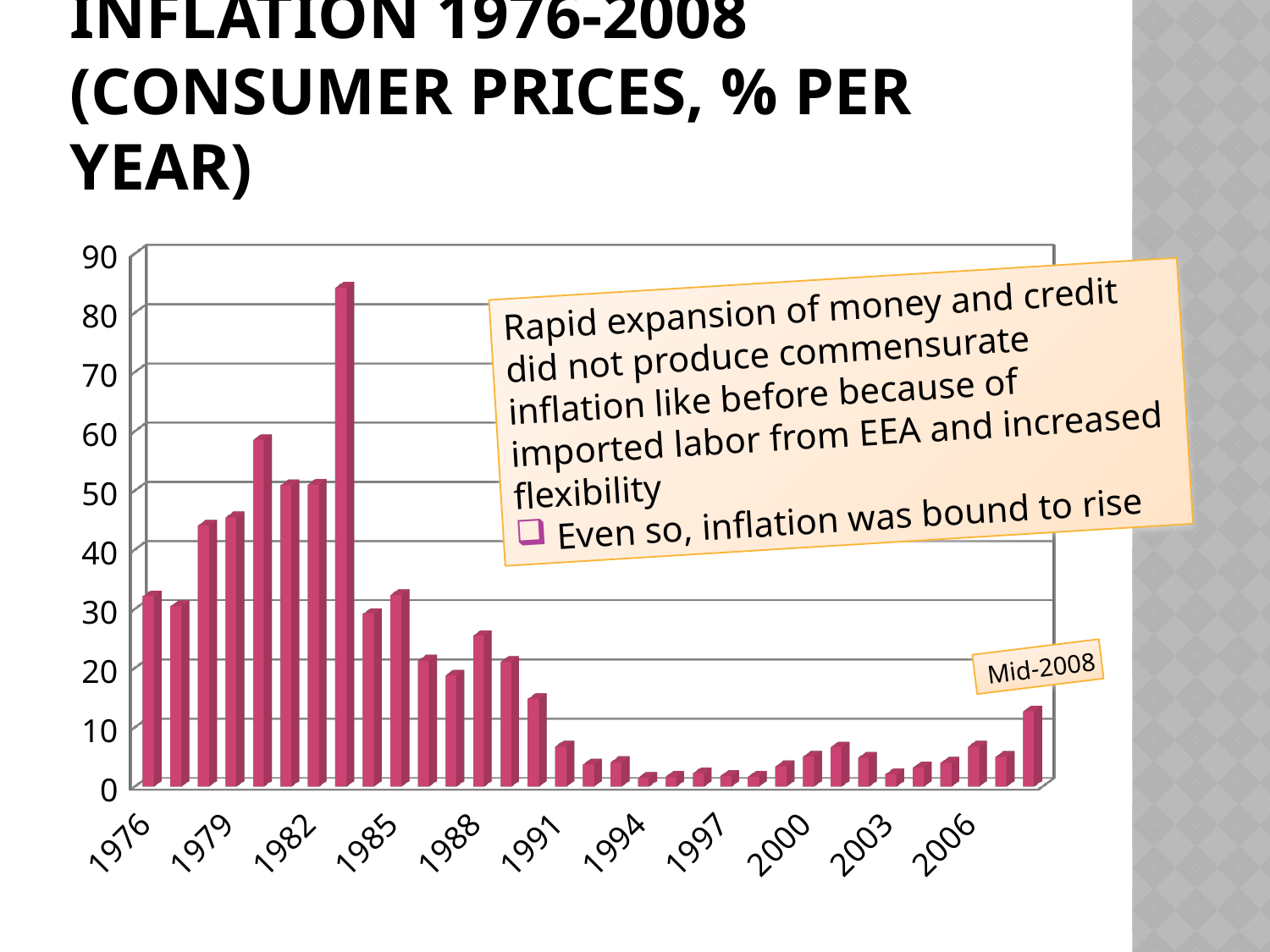
What kind of chart is shown on the slide? bar chart Is the value for the bar labelled Mid-2008 greater or less than 10? greater Is the value for 1979 greater or less than 40? greater Is the value for 1982 greater or less than 60? less Which year has the larger value, 1982 or 2000? 1982 Which year has the larger value, 1979 or 1991? 1979 Do the values generally rise or fall from 1983 to 1994? fall What is the highest value shown on the vertical axis? 90